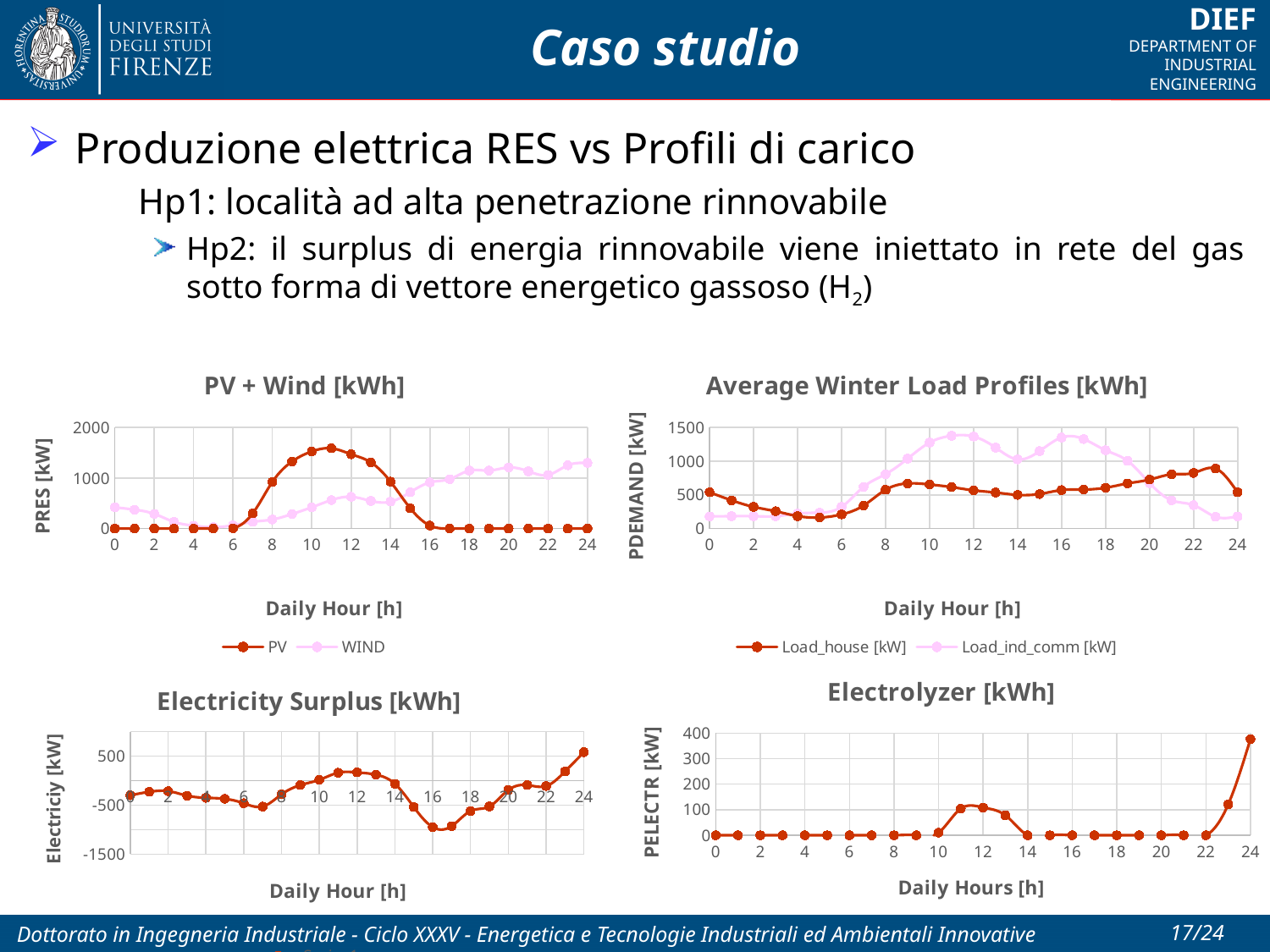
In the 'Electrolyzer [kWh]' chart, do the values rise or fall from hour 22 to hour 24? rise In the 'Electrolyzer [kWh]' chart, is the value at hour 24 greater or less than 300? greater In the 'Electrolyzer [kWh]' chart, what is the value at hour 5? 0 How many series does the legend of the 'Average Winter Load Profiles [kWh]' chart list? 2 In the 'PV + Wind [kWh]' chart, at which hour does the PV series reach its highest value? 11 What kind of chart is the 'PV + Wind [kWh]' chart? line chart In the 'PV + Wind [kWh]' chart, at hour 11, which series has the larger value, PV or WIND? PV In the 'Average Winter Load Profiles [kWh]' chart, is the Load_house [kW] value at hour 5 greater or less than 500? less In the 'PV + Wind [kWh]' chart, what are the two series named in the legend? PV and WIND In the 'Average Winter Load Profiles [kWh]' chart, at hour 12, which series is larger, Load_house [kW] or Load_ind_comm [kW]? Load_ind_comm [kW] In the 'PV + Wind [kWh]' chart, what is the PV value at hour 0? 0 In the 'PV + Wind [kWh]' chart, is the PV value at hour 11 greater or less than 1000? greater